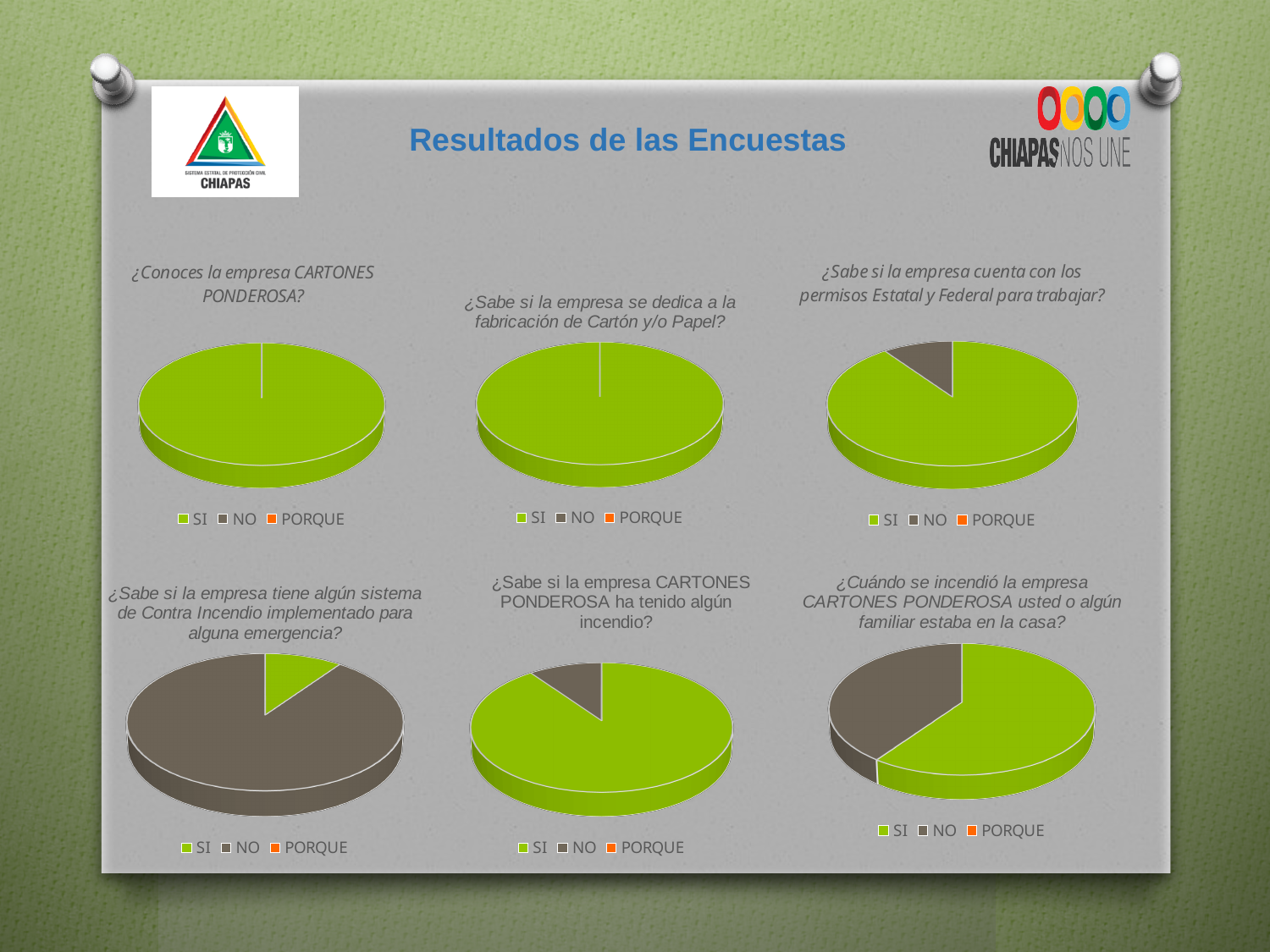
What kind of chart is used for '¿Conoces la empresa CARTONES PONDEROSA?'? pie chart In the chart '¿Sabe si la empresa se dedica a la fabricación de Cartón y/o Papel?', which category has the largest slice? SI In the chart '¿Sabe si la empresa CARTONES PONDEROSA ha tenido algún incendio?', which slice is larger, SI or NO? SI How many pie charts are shown on the slide? 6 In the chart '¿Cuándo se incendió la empresa CARTONES PONDEROSA usted o algún familiar estaba en la casa?', which slice is larger, SI or NO? SI In the chart '¿Sabe si la empresa tiene algún sistema de Contra Incendio implementado para alguna emergencia?', which category has the largest slice? NO What are the legend entries for the chart '¿Conoces la empresa CARTONES PONDEROSA?'? SI, NO, PORQUE In the chart '¿Sabe si la empresa tiene algún sistema de Contra Incendio implementado para alguna emergencia?', which slice is larger, SI or NO? NO What is the title of the slide? Resultados de las Encuestas How many entries does the legend list for the chart '¿Sabe si la empresa cuenta con los permisos Estatal y Federal para trabajar?'? 3 In the chart '¿Sabe si la empresa CARTONES PONDEROSA ha tenido algún incendio?', which category has the largest slice? SI